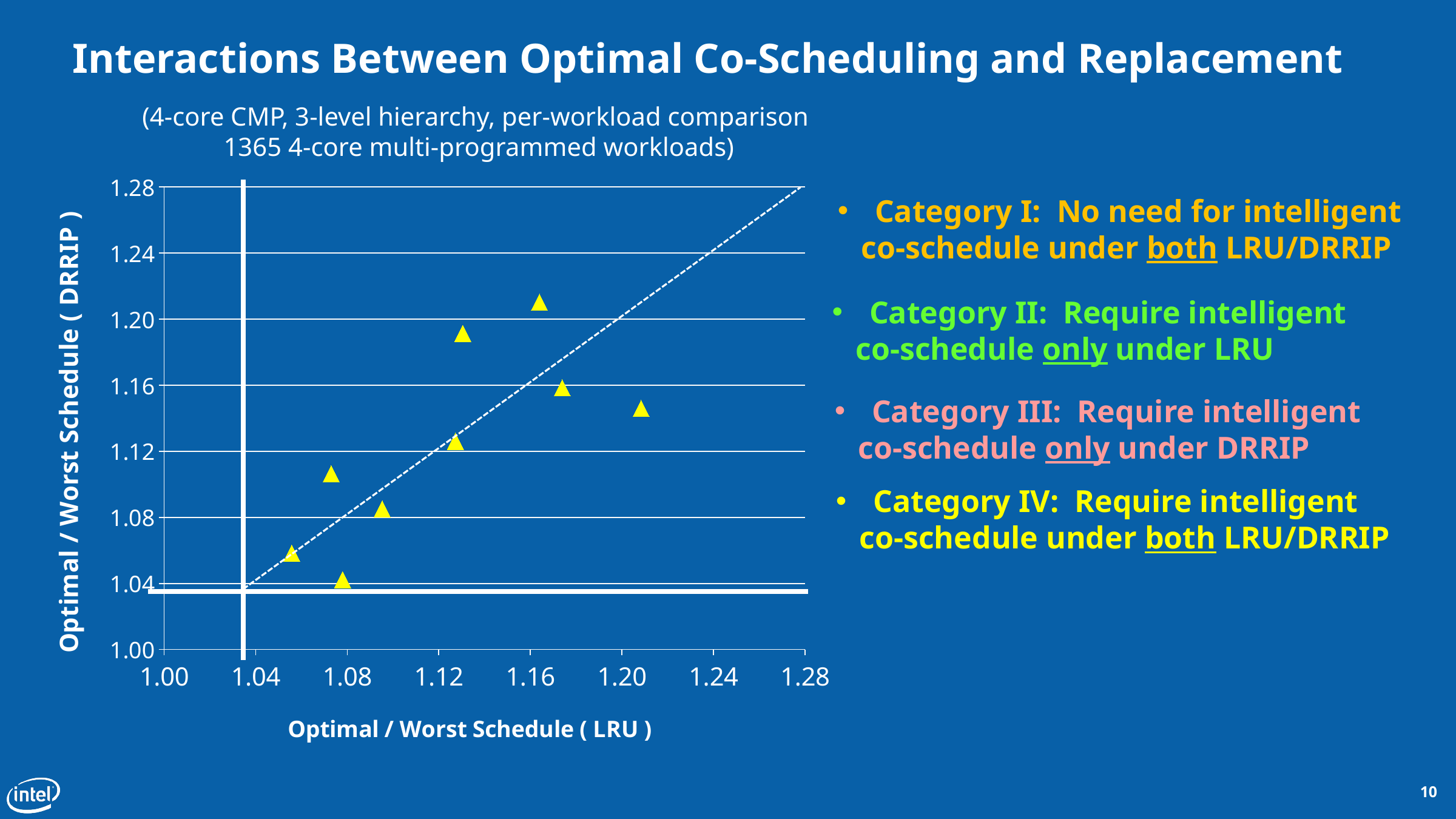
Is the y value of the highest plotted point greater or less than 1.20? greater Is the y value of the lowest plotted point greater or less than 1.08? less How many plotted points have a y value below 1.08? 2 What is the lowest value shown on the y axis of the chart? 1.00 Is the x value of the rightmost plotted point greater or less than 1.20? greater How many plotted points have a y value greater than 1.20? 1 What is the title of the y axis of the chart? Optimal / Worst Schedule ( DRRIP ) What is the highest value shown on the x axis of the chart? 1.28 How many plotted points have an x value greater than 1.20? 1 What kind of chart is shown on the slide? scatter chart What is the title of the x axis of the chart? Optimal / Worst Schedule ( LRU )